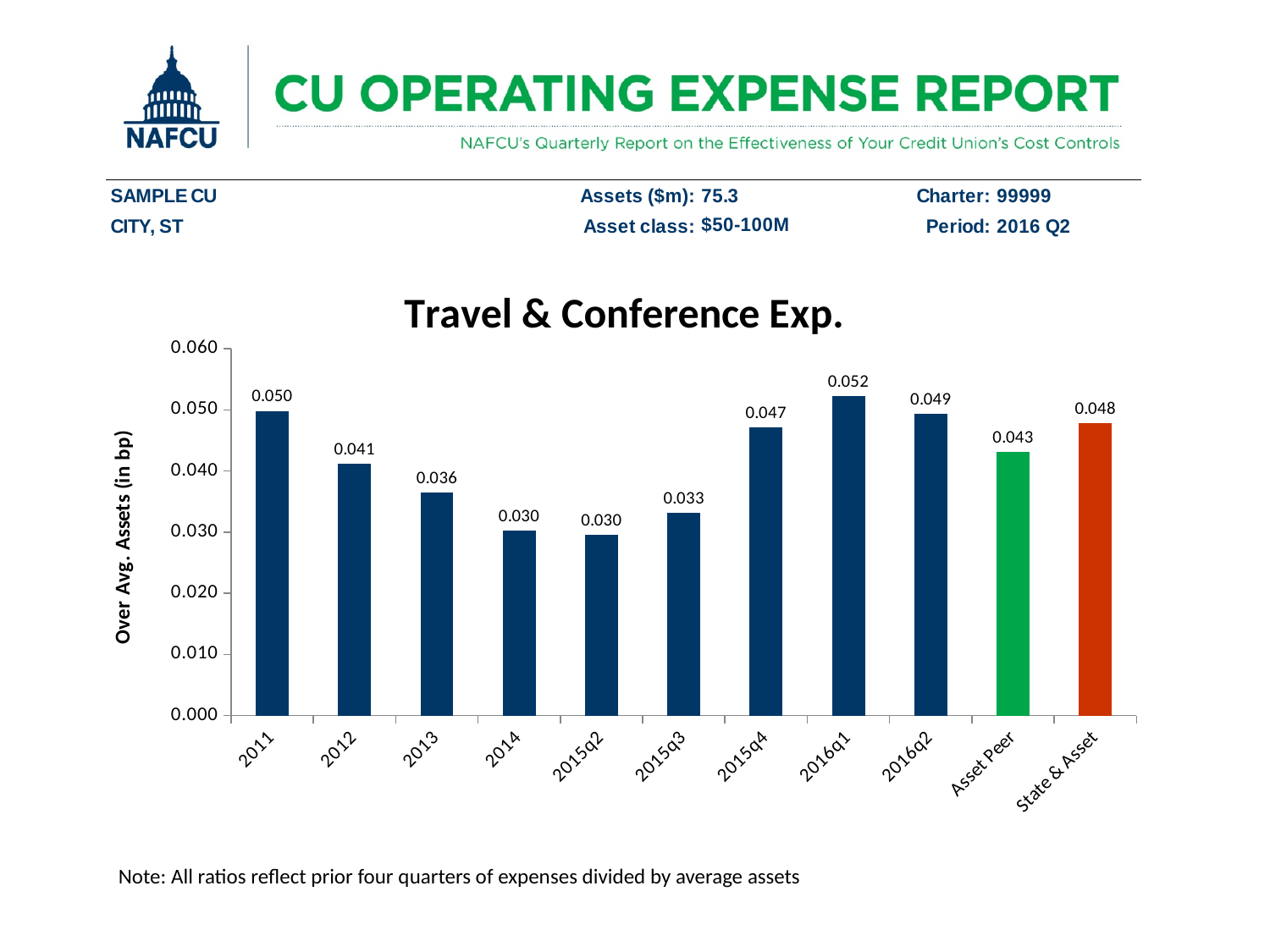
What is the value for Asset Peer? 0.043 What is the value for State & Asset? 0.048 What is the difference between the values for 2016q1 and 2016q2? 0.003 Do the values rise or fall from 2011 to 2014? fall What kind of chart is this? bar chart What is the title of the chart? Travel & Conference Exp. What is the value for 2016q1? 0.052 Which category has the highest value? 2016q1 How many categories are shown on the x axis? 11 What is the value for 2011? 0.050 Is the value for 2015q4 greater or less than 0.040? greater Which is larger, the value for 2012 or the value for 2013? 2012